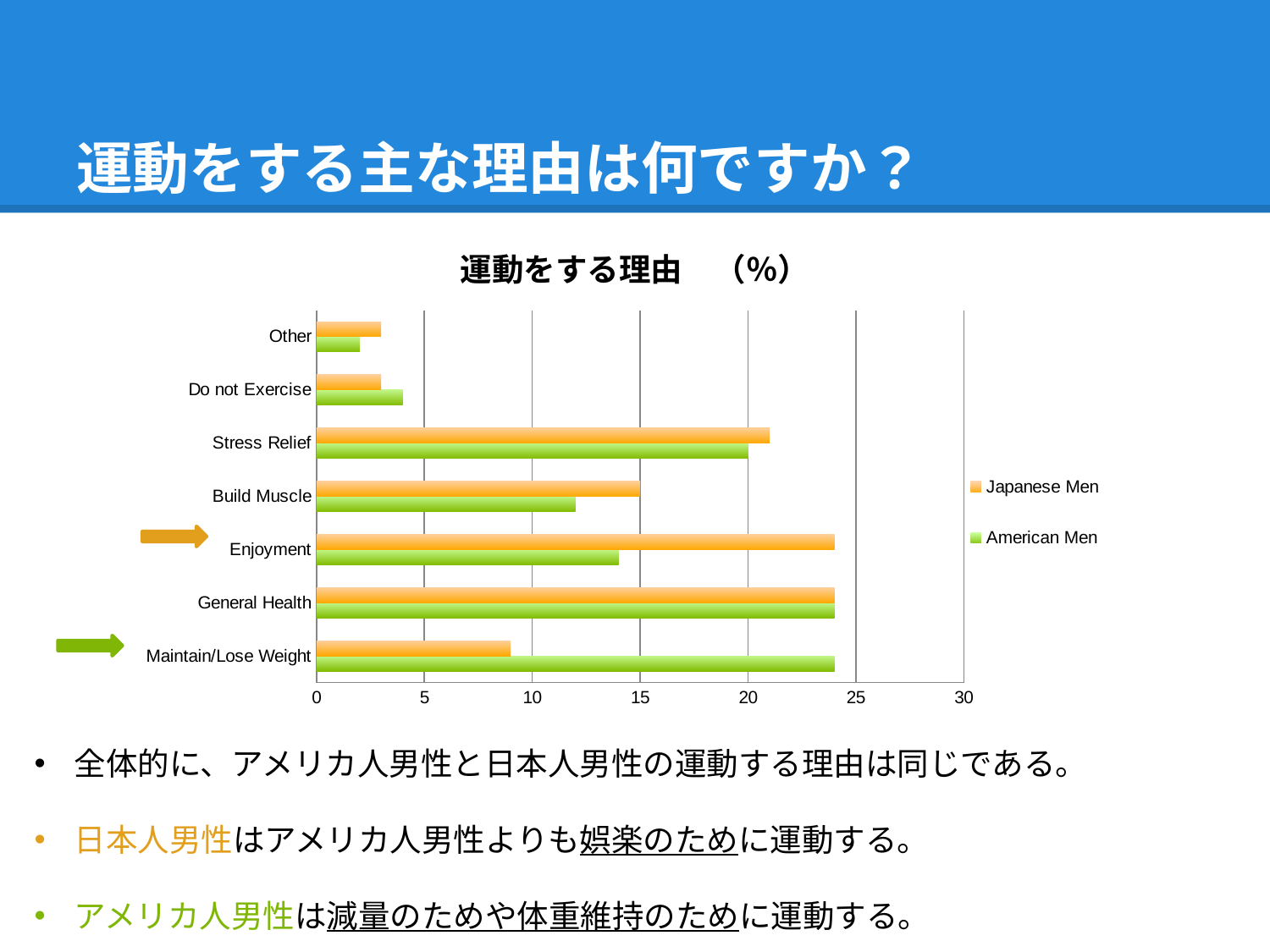
For Maintain/Lose Weight, which is larger: Japanese Men or American Men? American Men Is the value for American Men in Enjoyment greater or less than 15? less Is the value for Japanese Men in Maintain/Lose Weight greater or less than 10? less What kind of chart is shown on the slide? bar chart For Build Muscle, which is larger: Japanese Men or American Men? Japanese Men How many series does the legend list? 2 Which series is shown in green? American Men How many categories are shown on the chart? 7 Which category has the lowest value for American Men? Other Is the value for American Men in Do not Exercise greater or less than 5? less For Enjoyment, which is larger: Japanese Men or American Men? Japanese Men